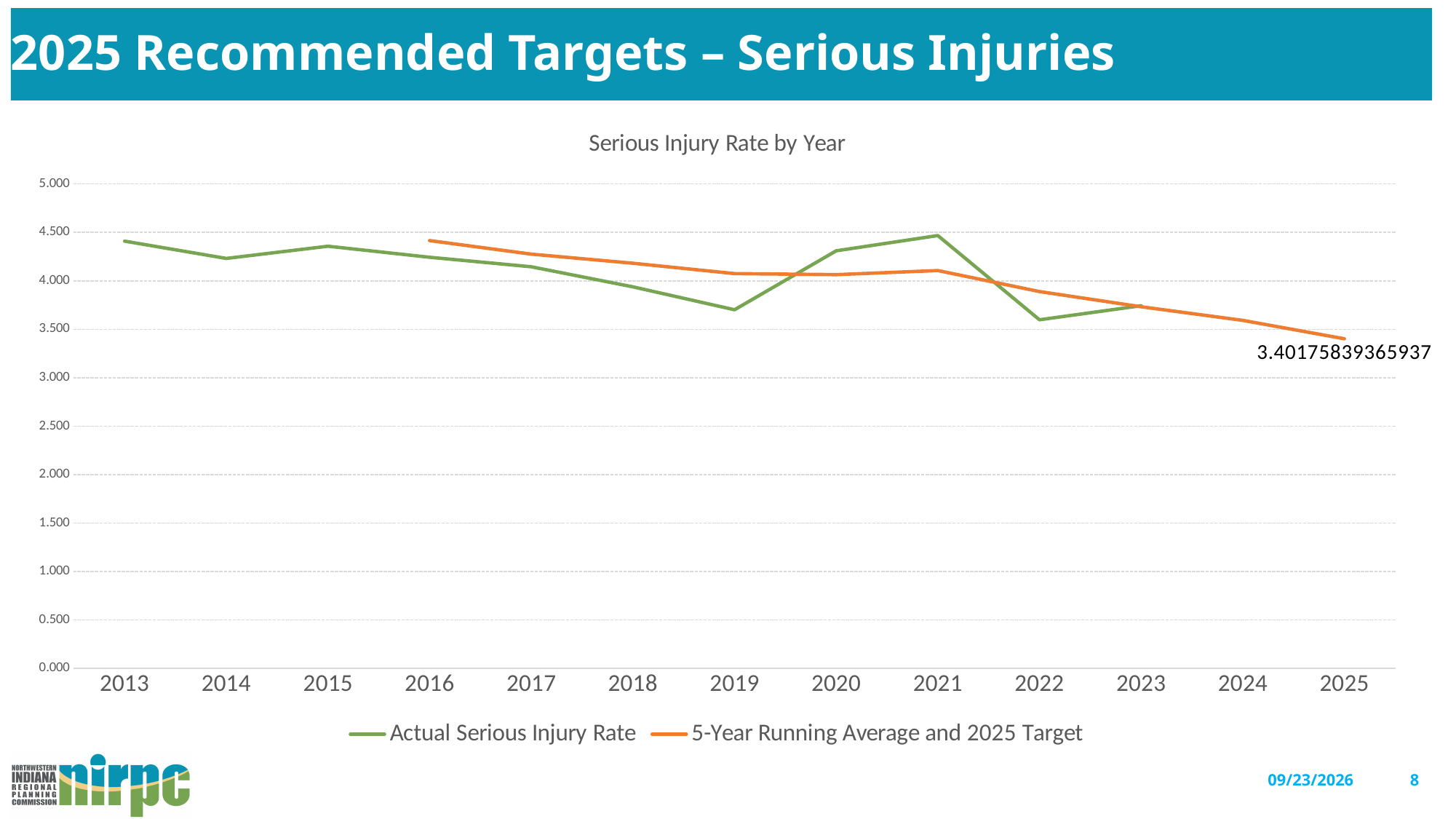
Is the 5-Year Running Average and 2025 Target value in 2025 greater or less than 3.500? less In which year is the Actual Serious Injury Rate lowest? 2022 What colour is the Actual Serious Injury Rate line? green How many years are shown on the x axis? 13 Is the Actual Serious Injury Rate in 2019 greater or less than 4.000? less What kind of chart is shown on the slide? line chart What is the labelled value of the 5-Year Running Average and 2025 Target line in 2025? 3.40175839365937 Which is larger in 2020: the Actual Serious Injury Rate or the 5-Year Running Average and 2025 Target? Actual Serious Injury Rate Does the 5-Year Running Average and 2025 Target line rise or fall from 2016 to 2025? fall What is the title of the chart? Serious Injury Rate by Year Is the Actual Serious Injury Rate in 2021 greater or less than 4.000? greater How many series does the legend list? 2